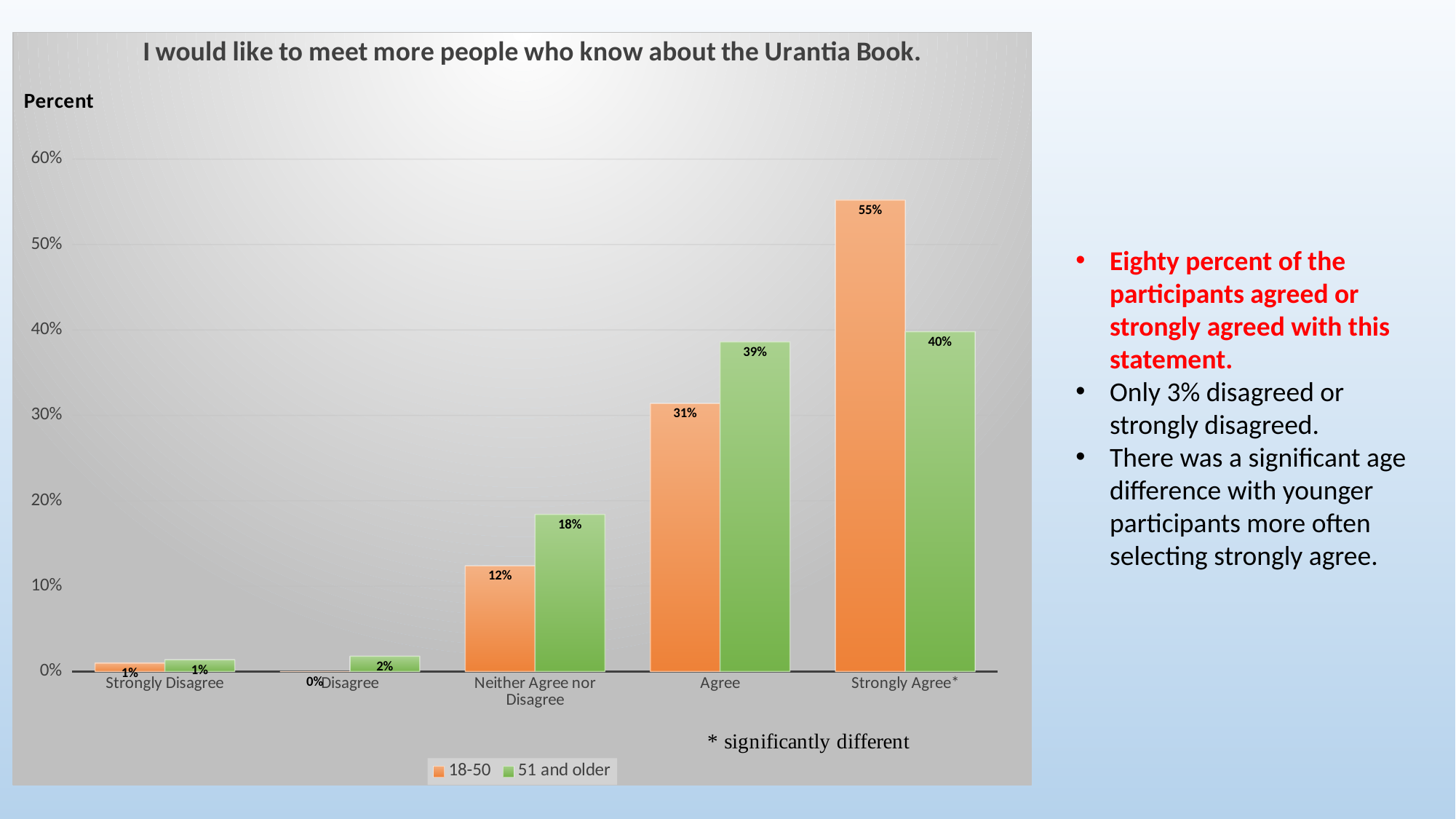
What is the value for the 51 and older group in the Neither Agree nor Disagree category? 18% Which category has the highest value for the 51 and older group? Strongly Agree* In the Agree category, which group has the larger value, 18-50 or 51 and older? 51 and older What is the title of the chart? I would like to meet more people who know about the Urantia Book. What is the difference between the 18-50 and 51 and older values in the Strongly Agree* category? 15% What kind of chart is shown on the slide? Bar chart How many response categories are shown on the x axis? 5 How many series does the legend list? 2 Which category has the highest value for the 18-50 group? Strongly Agree* What is the value for the 18-50 group in the Strongly Agree* category? 55% What is the value for the 18-50 group in the Disagree category? 0% What is the value for the 51 and older group in the Agree category? 39%